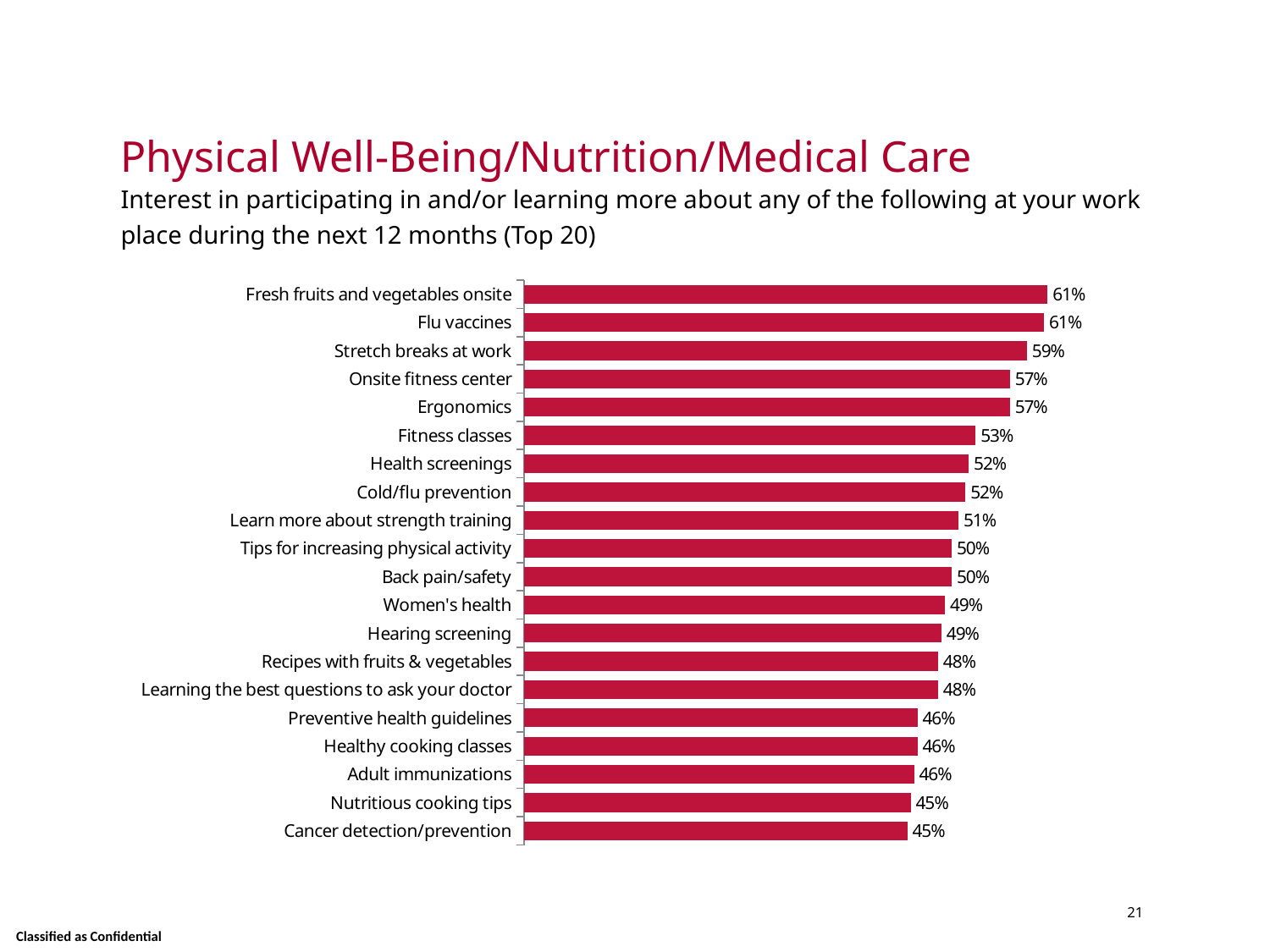
What is the value shown for Learning the best questions to ask your doctor? 48% What kind of chart is shown on the slide? Bar chart What is the difference between the values for Ergonomics and Adult immunizations? 11% What colour are the bars in the chart? Red What percentage of respondents expressed interest in Stretch breaks at work? 59% What is the value shown for Cancer detection/prevention? 45% Which is larger, the value for Women's health or the value for Onsite fitness center? Onsite fitness center What is the value shown for Fitness classes? 53% How many categories are shown on the chart? 20 What is the difference between the values for Fresh fruits and vegetables onsite and Fitness classes? 8% Which category has the lowest value on the chart? Cancer detection/prevention and Nutritious cooking tips (both 45%) Which is larger, the value for Flu vaccines or the value for Health screenings? Flu vaccines